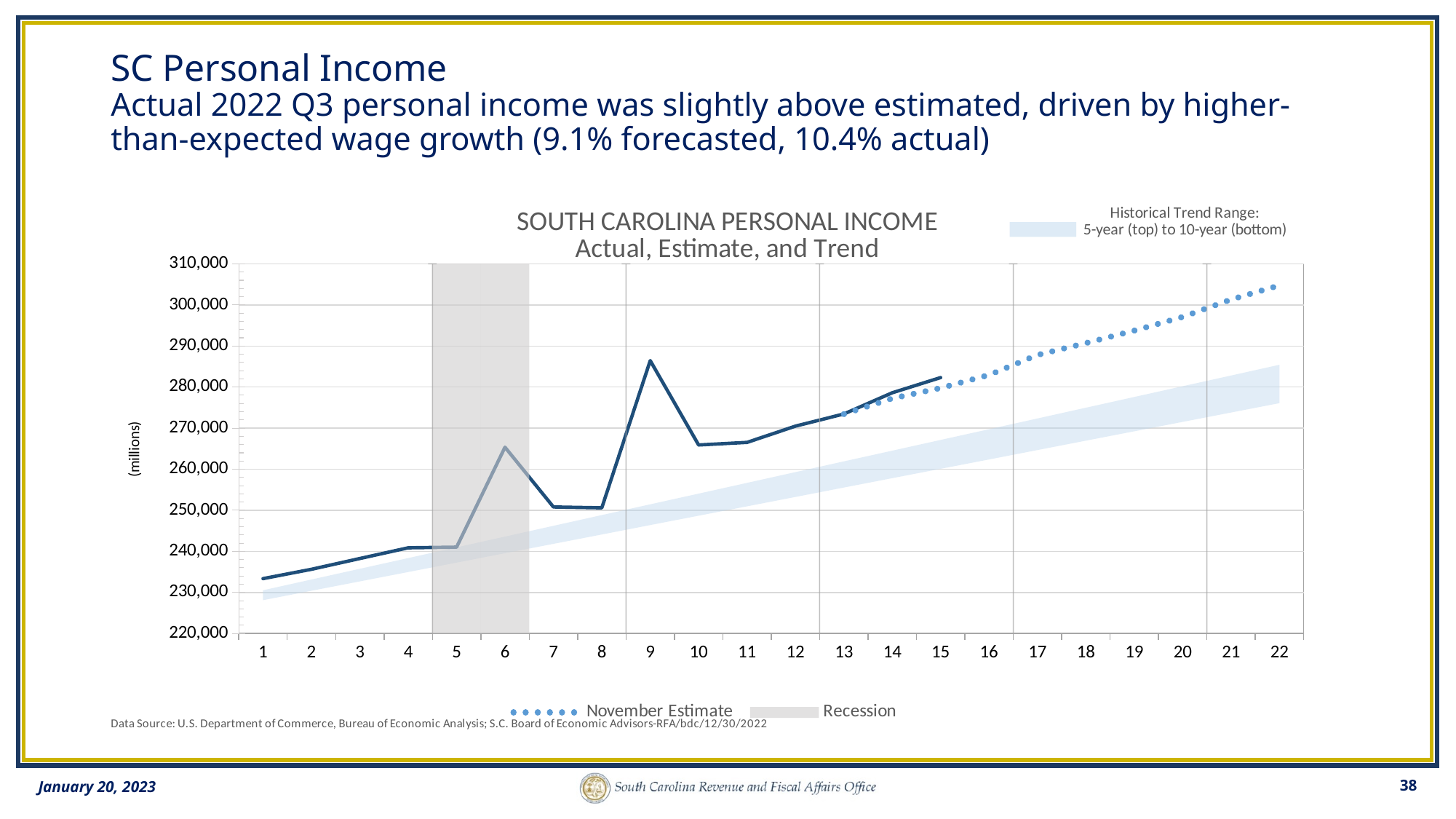
At which x-axis period is the actual personal income line at its lowest? 1 At which x-axis period does the actual personal income line reach its highest point? 9 Is the November Estimate value at period 22 greater or less than 300,000? greater What kind of chart is shown on the slide? line chart Is the value of the actual personal income line at period 1 greater or less than 240,000? less Does the November Estimate dotted line rise or fall from period 13 to period 22? rise How many periods are labeled along the x axis of the chart? 22 Which is higher on the actual personal income line: the value at period 9 or the value at period 6? period 9 How many entries does the legend below the chart list? 2 Is the value of the actual personal income line at period 10 greater or less than 260,000? greater What is the title of the chart? SOUTH CAROLINA PERSONAL INCOME Actual, Estimate, and Trend